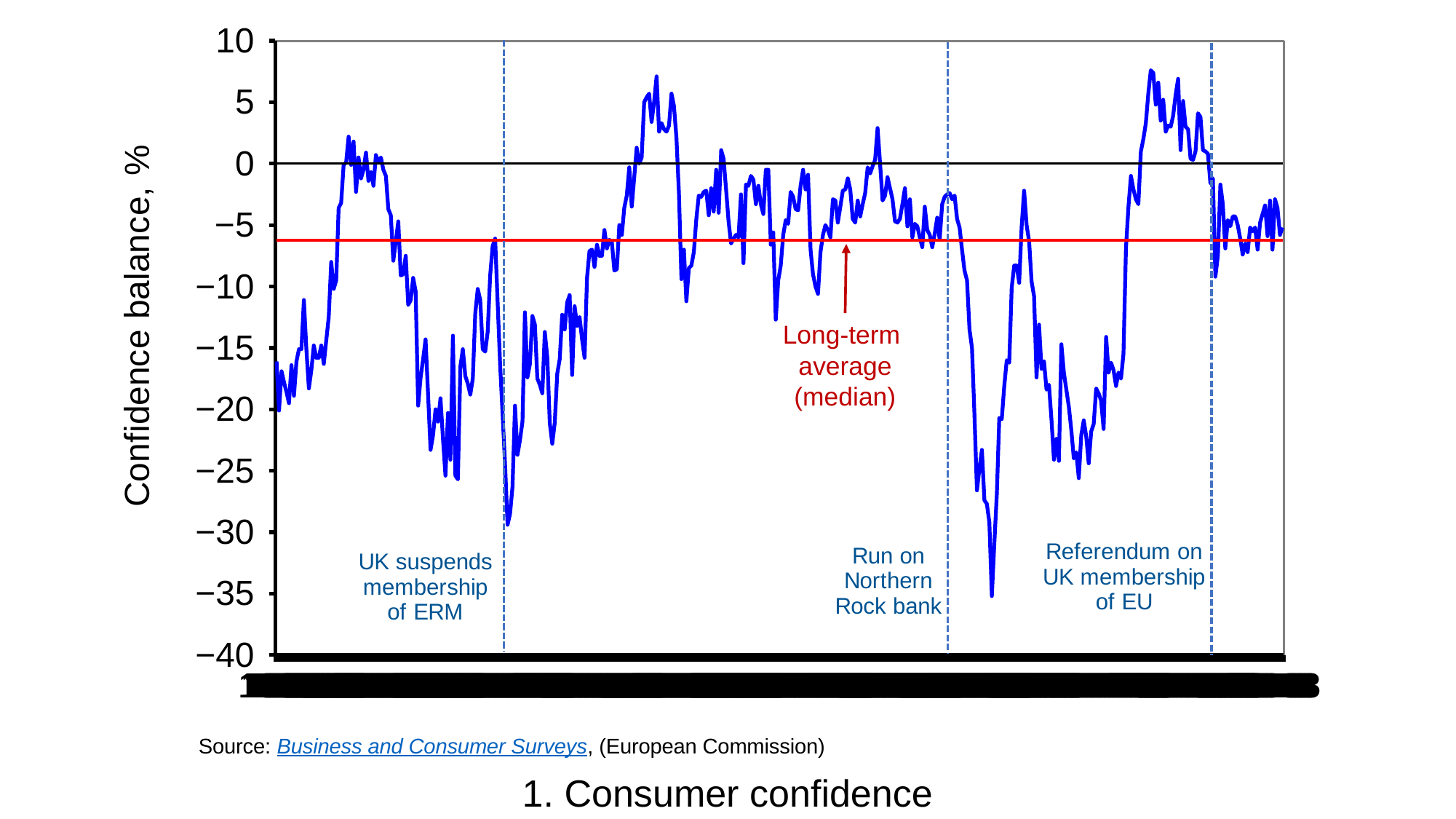
What does the red horizontal line represent? Long-term average (median) How many events are marked with dashed vertical lines on the chart? 3 Is the lowest point of the confidence balance series greater or less than -30? less Immediately after the 'UK suspends membership of ERM' dashed line, does the confidence balance rise or fall? rise What type of chart is shown on the slide? line chart Is the highest point of the confidence balance series greater or less than 5? greater Is the long-term average (median) line greater or less than 0? less What is the label of the vertical axis? Confidence balance, % Immediately after the 'Run on Northern Rock bank' dashed line, does the confidence balance rise or fall? fall